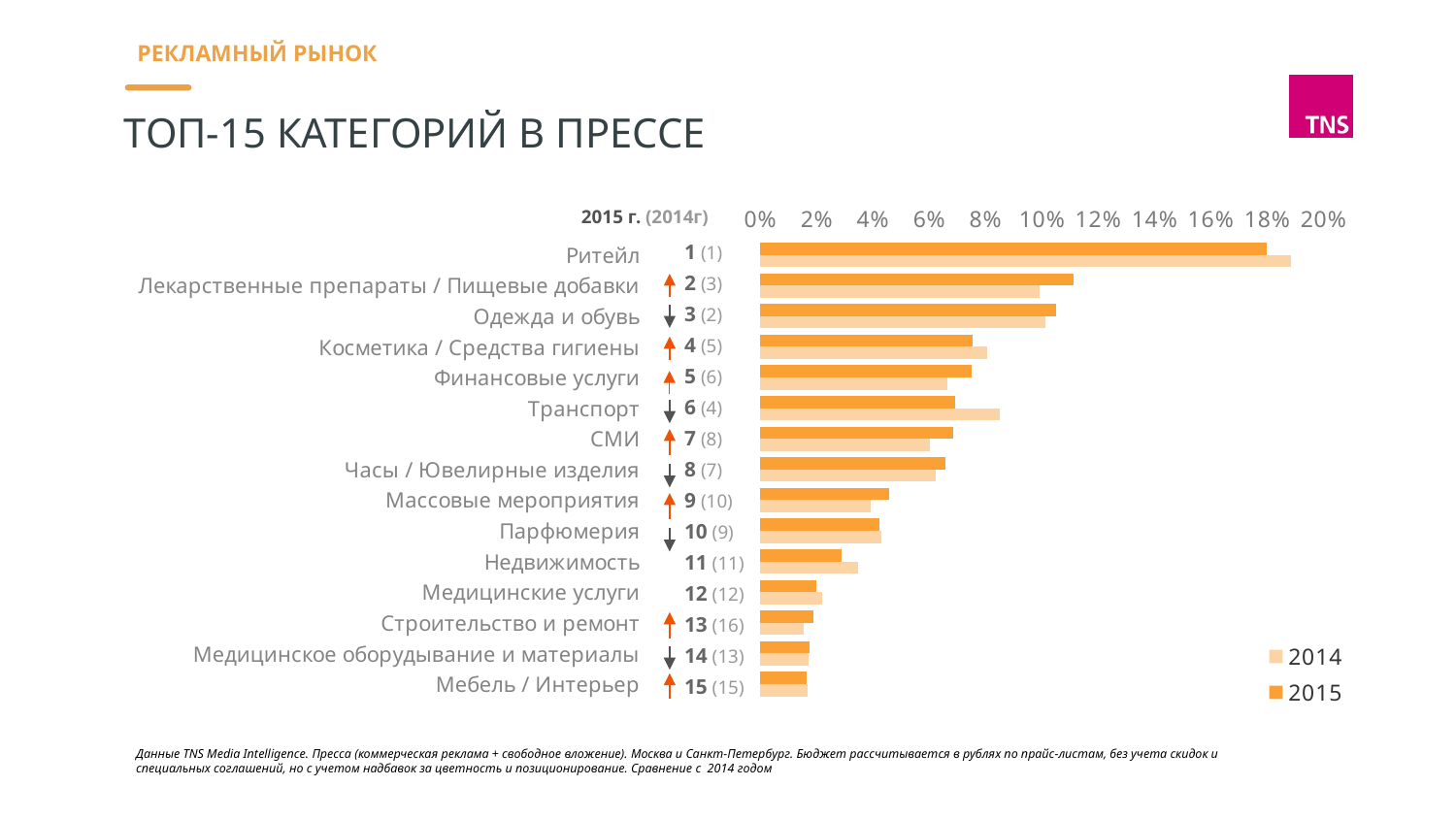
Which category has the highest value for 2015? Ритейл How many categories are plotted in the chart? 15 Which series is shown in the darker orange colour in the legend? 2015 Is the 2015 value for Ритейл greater or less than 16%? greater For Ритейл, which year has the larger value, 2014 or 2015? 2014 Is the 2015 value for Лекарственные препараты / Пищевые добавки greater or less than 10%? greater Is the 2015 value for Недвижимость greater or less than 4%? less How many series does the legend list? 2 What kind of chart is shown on the slide? bar chart What rank did Лекарственные препараты / Пищевые добавки hold in 2014, according to the number in parentheses? 3 For Транспорт, which year has the larger value, 2014 or 2015? 2014